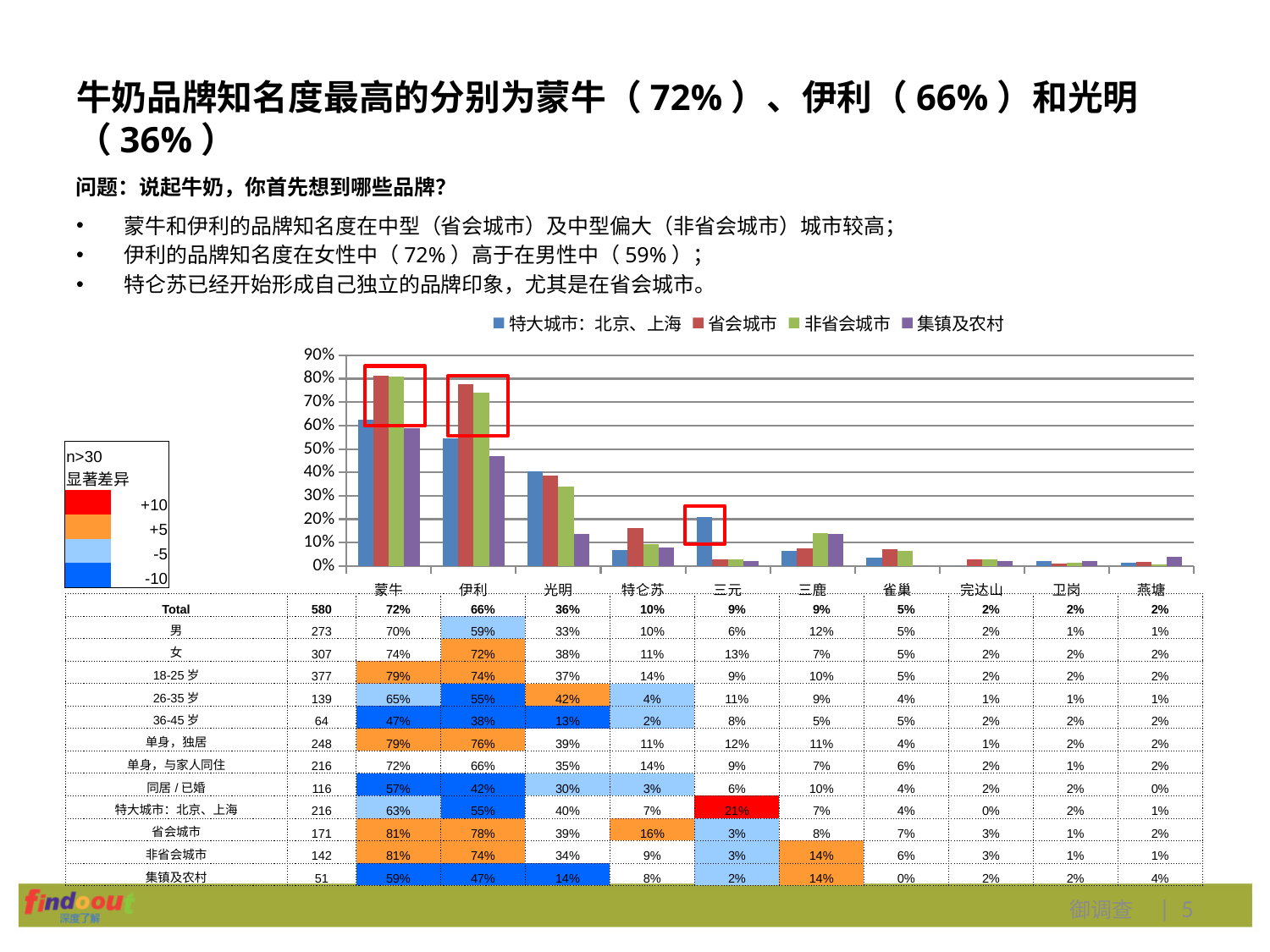
Is the 特大城市：北京、上海 value for 蒙牛 greater or less than 70%? less For 三元, which is larger: the 特大城市：北京、上海 value or the 省会城市 value? 特大城市：北京、上海 For 特仑苏, which is larger: the 省会城市 value or the 集镇及农村 value? 省会城市 Do the 特大城市：北京、上海 values generally rise or fall from 蒙牛 on the left to 燕塘 on the right? fall Is the 省会城市 value for 伊利 greater or less than 70%? greater Which brand has the highest value for the 特大城市：北京、上海 series? 蒙牛 For 光明, which series has the lowest value? 集镇及农村 How many series does the chart legend list? 4 According to the table under the chart, what is the 省会城市 value for 蒙牛? 81% Using the table values, what is the difference between the 省会城市 value (78%) and the 集镇及农村 value (47%) for 伊利? 31 percentage points What kind of chart is shown on the slide? bar chart How many milk brands are shown along the x axis of the chart? 10